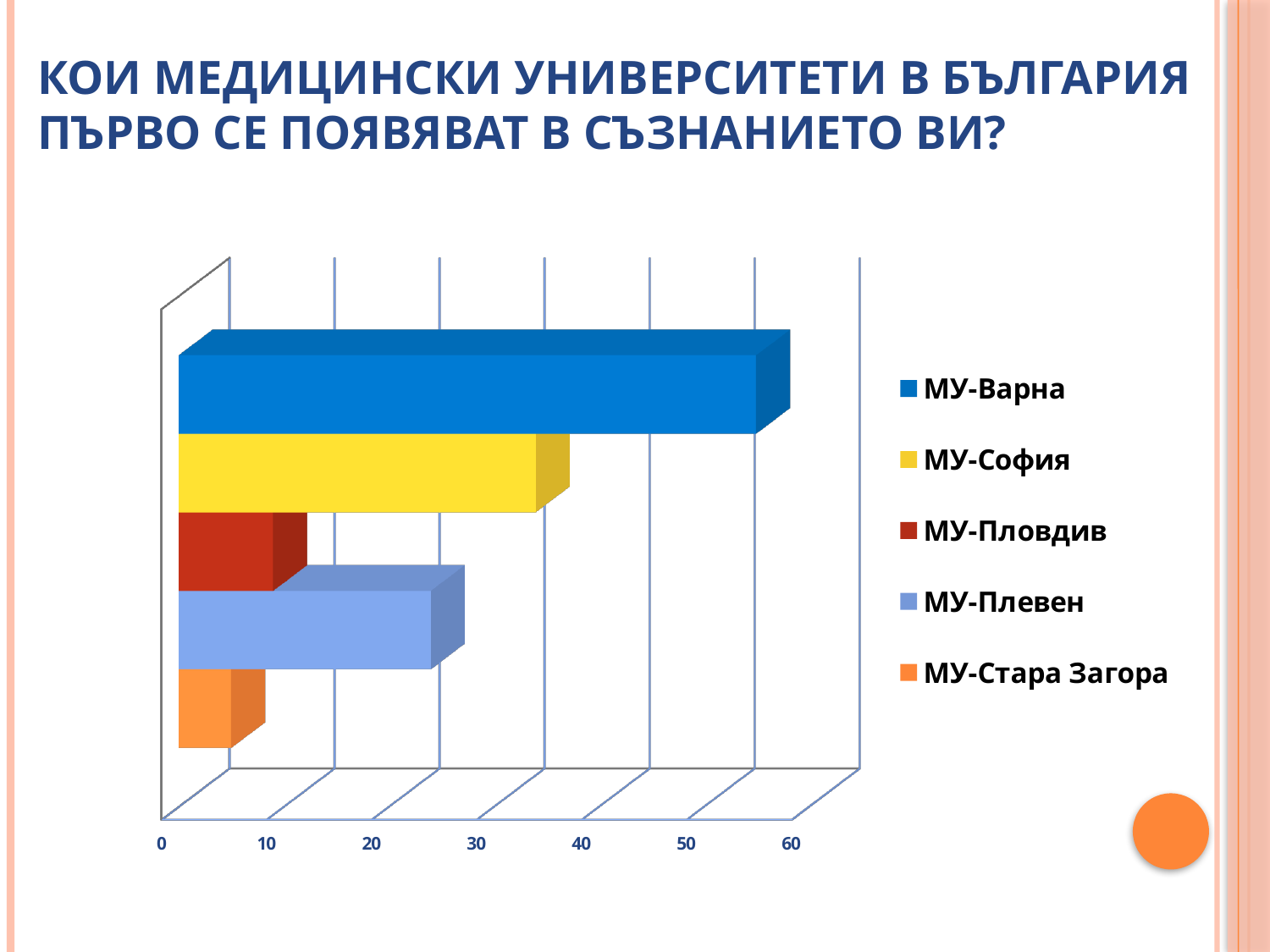
Is the value for МУ-Стара Загора greater or less than 10? less How many universities are shown in the chart? 5 Which has a larger value, МУ-Плевен or МУ-Пловдив? МУ-Плевен Is the value for МУ-Варна greater or less than 50? greater Is the value for МУ-София greater or less than 40? less What kind of chart is shown on the slide? bar chart How many entries does the legend list? 5 Which university has the lowest value in the chart? МУ-Стара Загора What colour is the bar for МУ-София? yellow Which university has the highest value in the chart? МУ-Варна